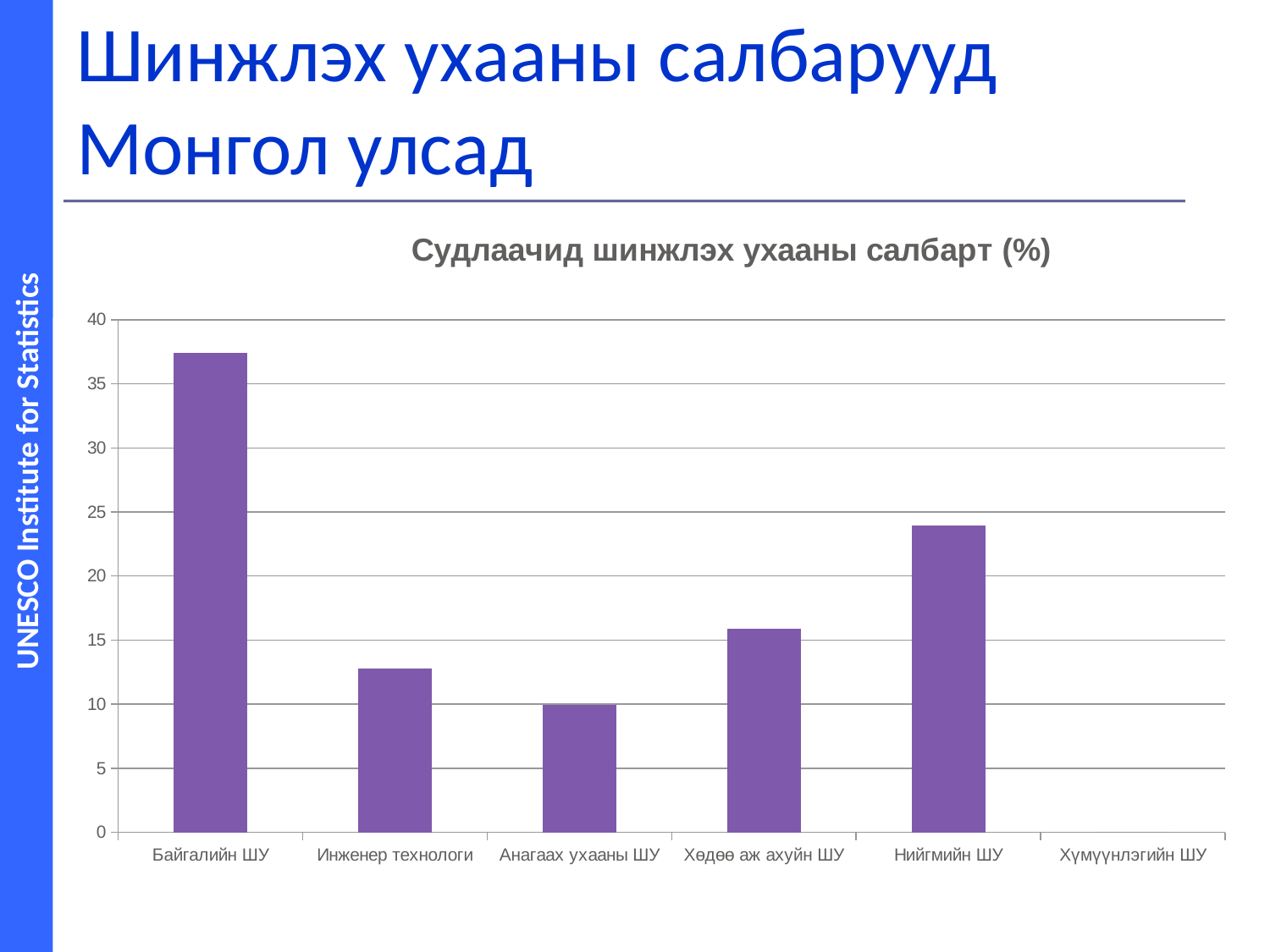
Which is larger, the value for Нийгмийн ШУ or the value for Хөдөө аж ахуйн ШУ? Нийгмийн ШУ What is the title of the chart? Судлаачид шинжлэх ухааны салбарт (%) Among the categories with a visible bar, which has the lowest value? Анагаах ухааны ШУ How many categories are listed on the x axis of the chart? 6 Is the value for Нийгмийн ШУ greater or less than 25? less What type of chart is shown on the slide? bar chart Is the value for Хөдөө аж ахуйн ШУ greater or less than 15? greater Is the value for Нийгмийн ШУ greater or less than 20? greater What colour are the bars in the chart? purple Which category has the highest value in the chart? Байгалийн ШУ